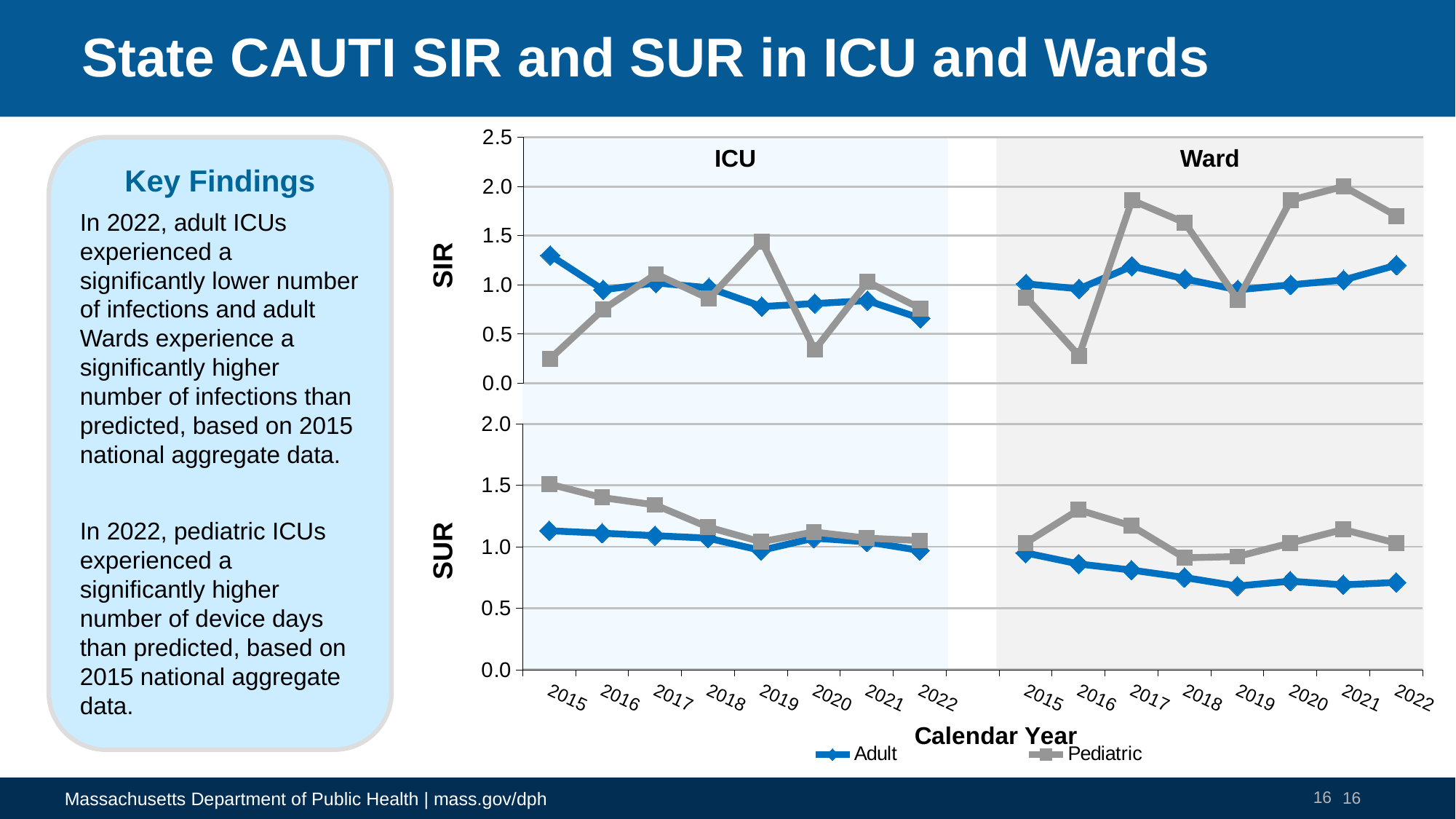
How many series does the legend list? 2 What kind of chart is shown on the slide? line chart What is the title of the x axis of the chart? Calendar Year How many calendar years are plotted in the ICU section of the SIR panel? 8 In the SIR panel, is the Pediatric Ward value for 2021 greater or less than 1.5? greater In the SIR panel, is the Adult ICU value for 2015 greater or less than 1.0? greater In the SIR panel, which year has the highest Pediatric Ward value? 2021 In the SUR panel, is the Adult Ward value for 2019 greater or less than 1.0? less In the SUR panel for ICU in 2015, which series has the larger value, Adult or Pediatric? Pediatric In the SIR panel, which year has the lowest Pediatric Ward value? 2016 In the SUR panel, does the Pediatric ICU line generally rise or fall from 2015 to 2022? fall